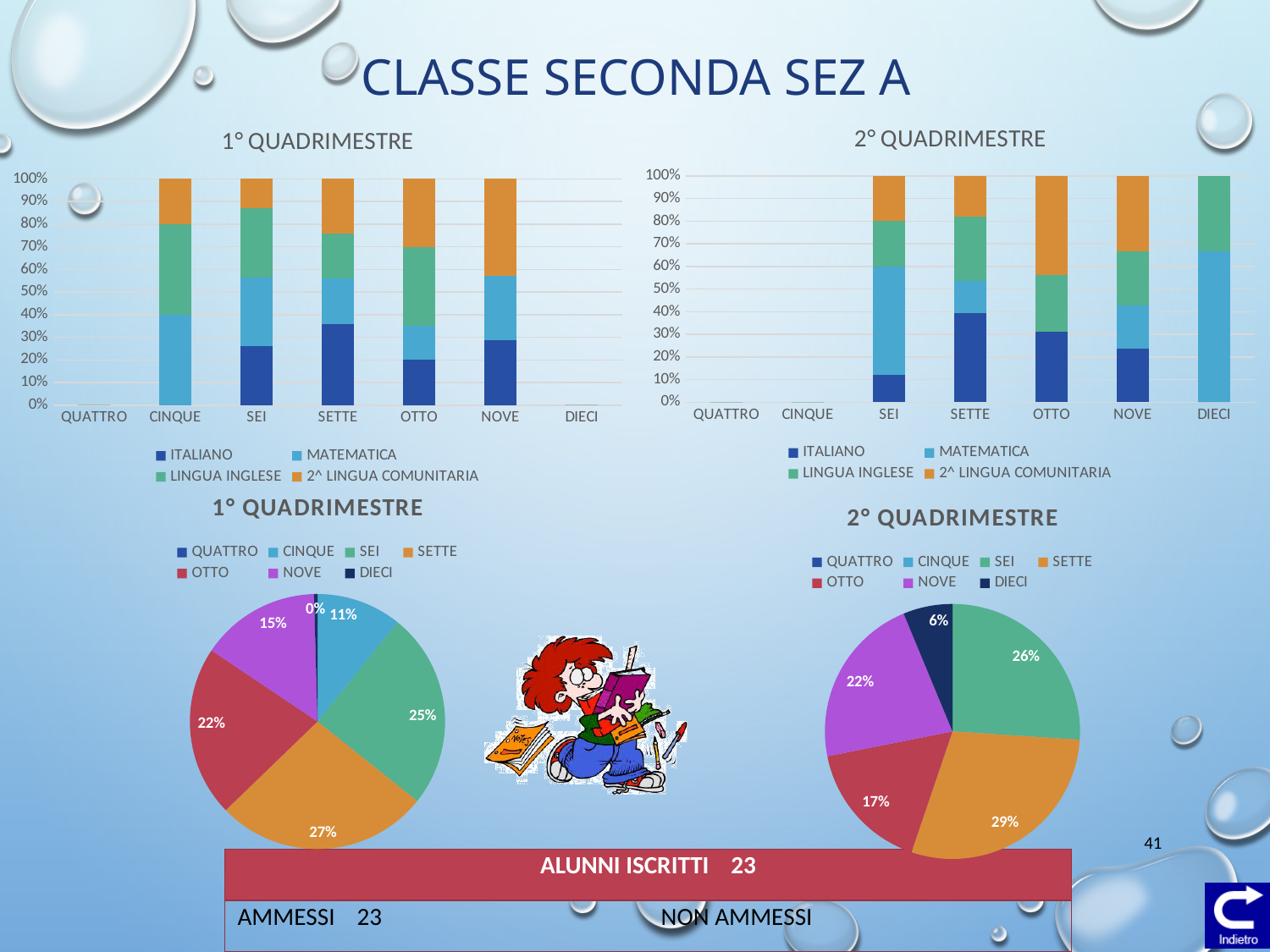
In the 1° QUADRIMESTRE pie chart, what is the difference between the shares of SETTE and NOVE? 12% In the 2° QUADRIMESTRE stacked bar chart, is the ITALIANO value for SETTE greater or less than 30%? greater In the 2° QUADRIMESTRE pie chart, which is larger, the share of SEI or the share of OTTO? SEI How many categories are shown on the x axis of the 2° QUADRIMESTRE stacked bar chart? 7 What kind of chart is the 1° QUADRIMESTRE chart at the top left of the slide? Stacked bar chart In the 2° QUADRIMESTRE pie chart, what percentage is shown for DIECI? 6% In the 2° QUADRIMESTRE pie chart, what is the difference between the shares of SETTE and OTTO? 12% In the 2° QUADRIMESTRE stacked bar chart, which is larger, the ITALIANO value for SETTE or for SEI? SETTE In the 1° QUADRIMESTRE pie chart, what percentage is shown for SETTE? 27% In the 2° QUADRIMESTRE pie chart, which category has the largest share? SETTE How many series does the legend of the 1° QUADRIMESTRE stacked bar chart list? 4 In the 1° QUADRIMESTRE pie chart, what percentage is shown for CINQUE? 11%